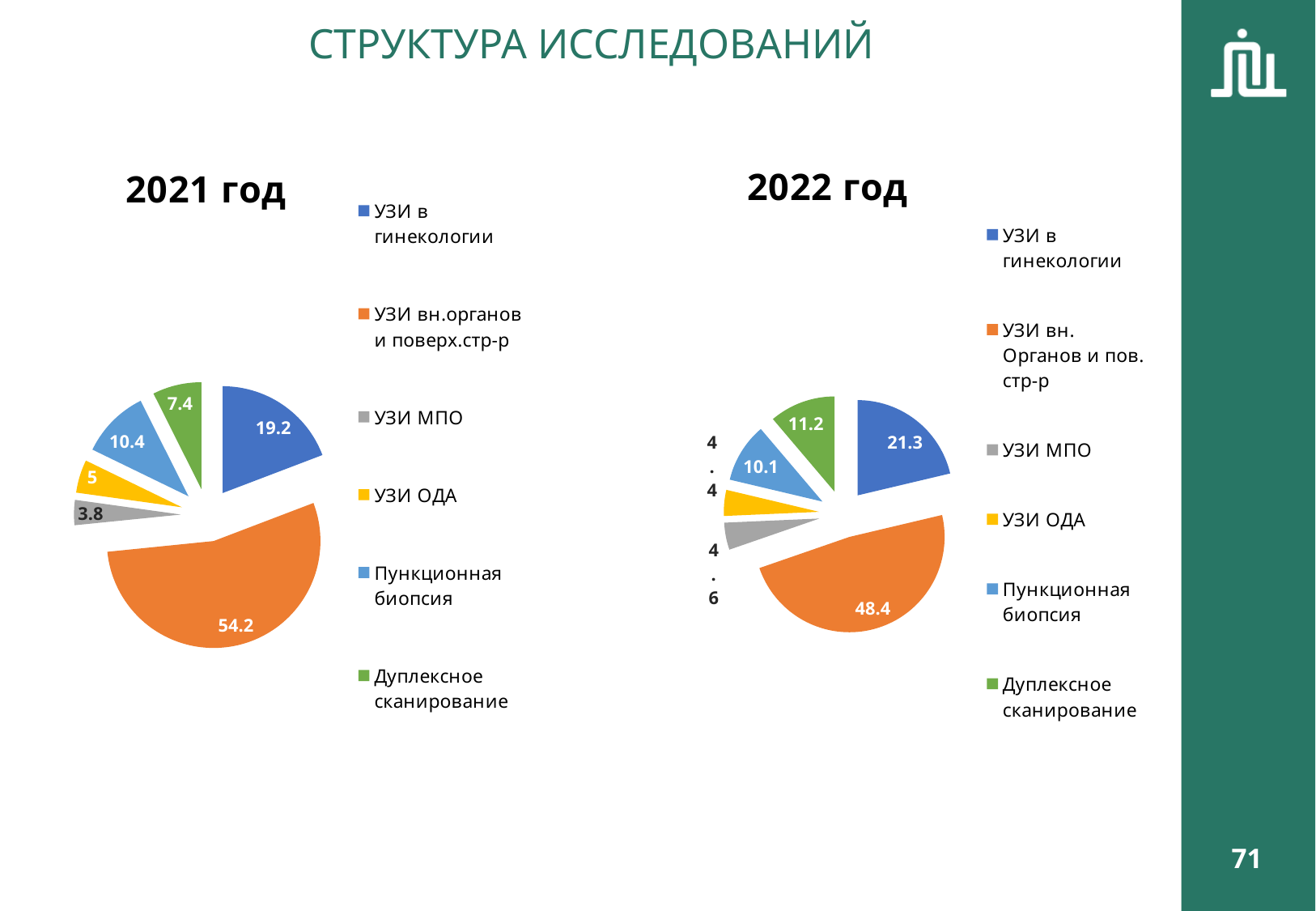
In the 2022 год pie chart, which category has the largest slice? УЗИ вн. Органов и пов. стр-р In the 2021 год pie chart, what colour is the УЗИ ОДА slice? Yellow In the 2021 год pie chart, which category has the smallest slice? УЗИ МПО In the 2022 год pie chart, what is the value for Дуплексное сканирование? 11.2 In the 2021 год pie chart, what is the value for УЗИ в гинекологии? 19.2 In the 2021 год pie chart, which category has the largest slice? УЗИ вн.органов и поверх.стр-р In the 2022 год pie chart, what is the value for УЗИ вн. Органов и пов. стр-р? 48.4 In the 2022 год pie chart, which is larger: Пункционная биопсия or Дуплексное сканирование? Дуплексное сканирование In the 2021 год pie chart, what is the value for Пункционная биопсия? 10.4 How many slices does the 2021 год pie chart have? 6 What type of chart is used for 2022 год? Pie chart What is the difference between the УЗИ в гинекологии values in the 2022 год and 2021 год pie charts? 2.1